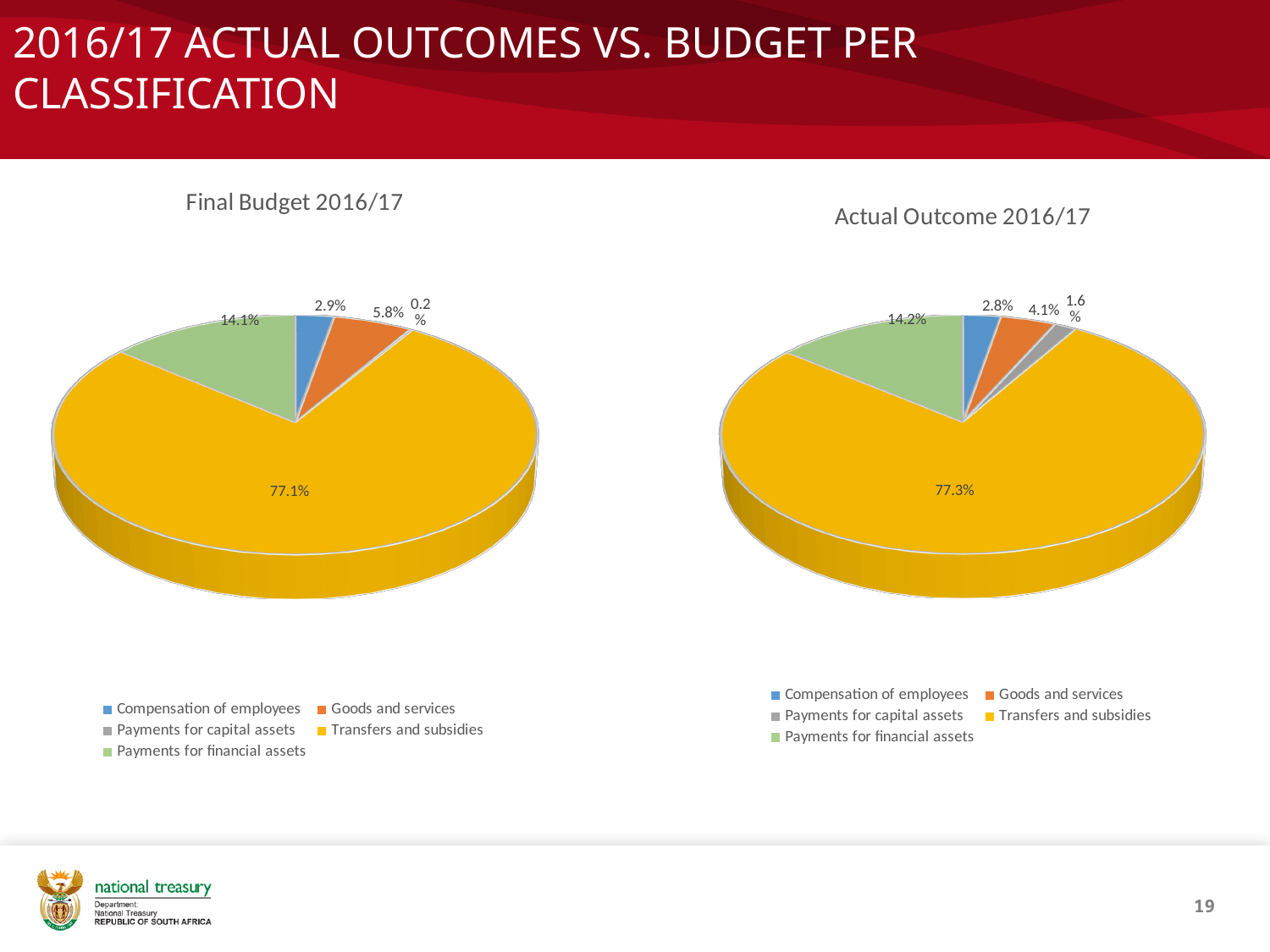
In the Final Budget 2016/17 chart, which category has the smallest share? Payments for capital assets In the Actual Outcome 2016/17 chart, which is larger: Goods and services or Compensation of employees? Goods and services What type of chart is the Actual Outcome 2016/17 chart? Pie chart In the Actual Outcome 2016/17 chart, what share is Transfers and subsidies? 77.3% In the Final Budget 2016/17 chart, what share is Payments for financial assets? 14.1% In the Final Budget 2016/17 chart, what share is Transfers and subsidies? 77.1% What is the difference between the Goods and services share in the Final Budget 2016/17 chart and in the Actual Outcome 2016/17 chart? 1.7% How many categories does the Final Budget 2016/17 chart show? 5 In the Actual Outcome 2016/17 chart, which category has the largest share? Transfers and subsidies In the Actual Outcome 2016/17 chart, what share is Compensation of employees? 2.8% In the Actual Outcome 2016/17 chart, what share is Payments for capital assets? 1.6% In the Final Budget 2016/17 chart, what share is Goods and services? 5.8%